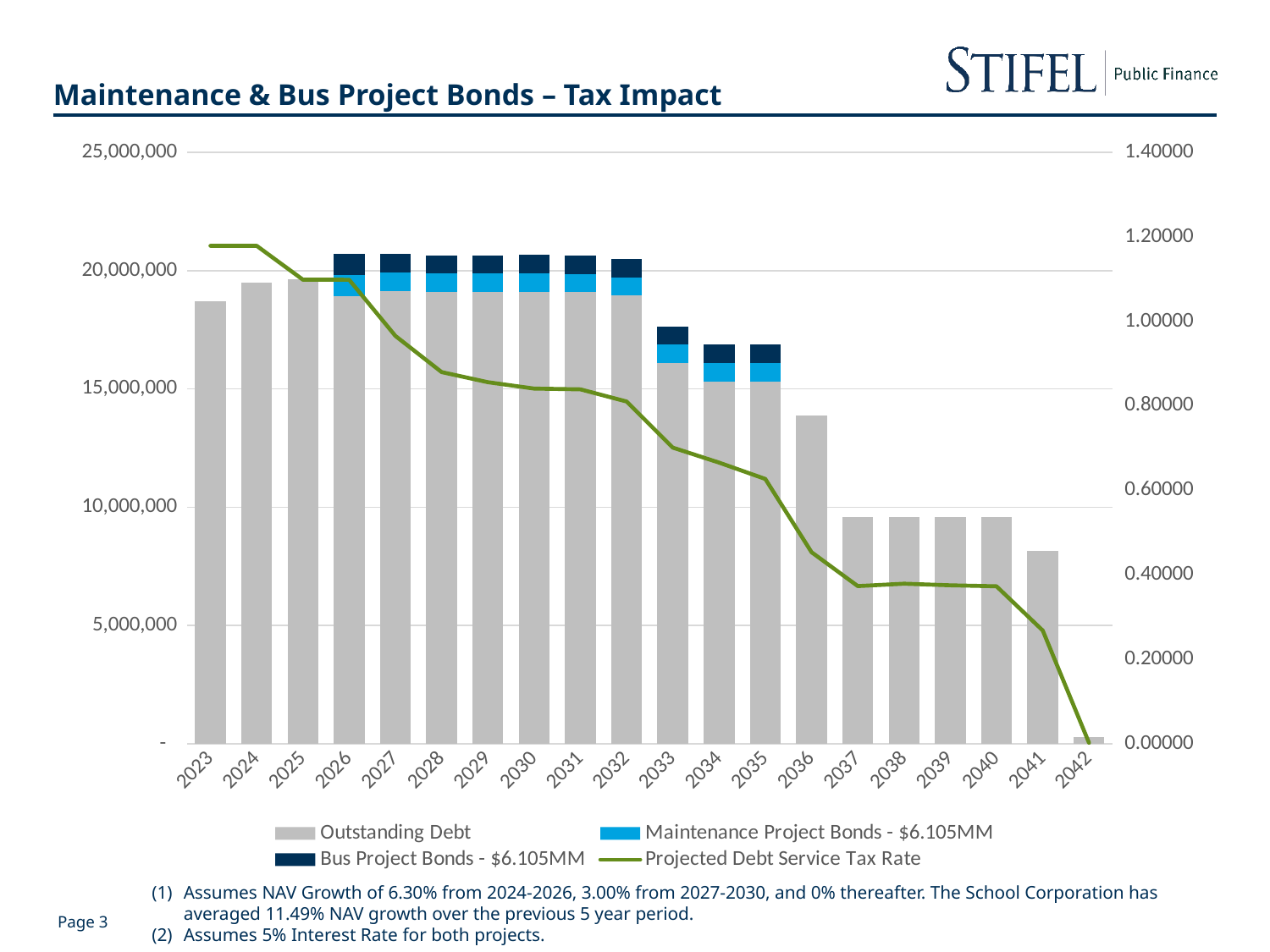
What kind of chart is shown on the slide? A stacked bar chart combined with a line chart Which is larger, the total bar for 2023 or the total bar for 2036? 2023 Which year has the lowest total bar? 2042 Is the Projected Debt Service Tax Rate for 2042 greater or less than 0.20000? less What is the title of the chart? Maintenance & Bus Project Bonds – Tax Impact How many years are shown on the x axis? 20 Is the Outstanding Debt bar for 2041 greater or less than 10,000,000? less Is the Projected Debt Service Tax Rate for 2023 greater or less than 1.00000? greater Does the Projected Debt Service Tax Rate line generally rise or fall from 2023 to 2042? fall How many series does the legend list? 4